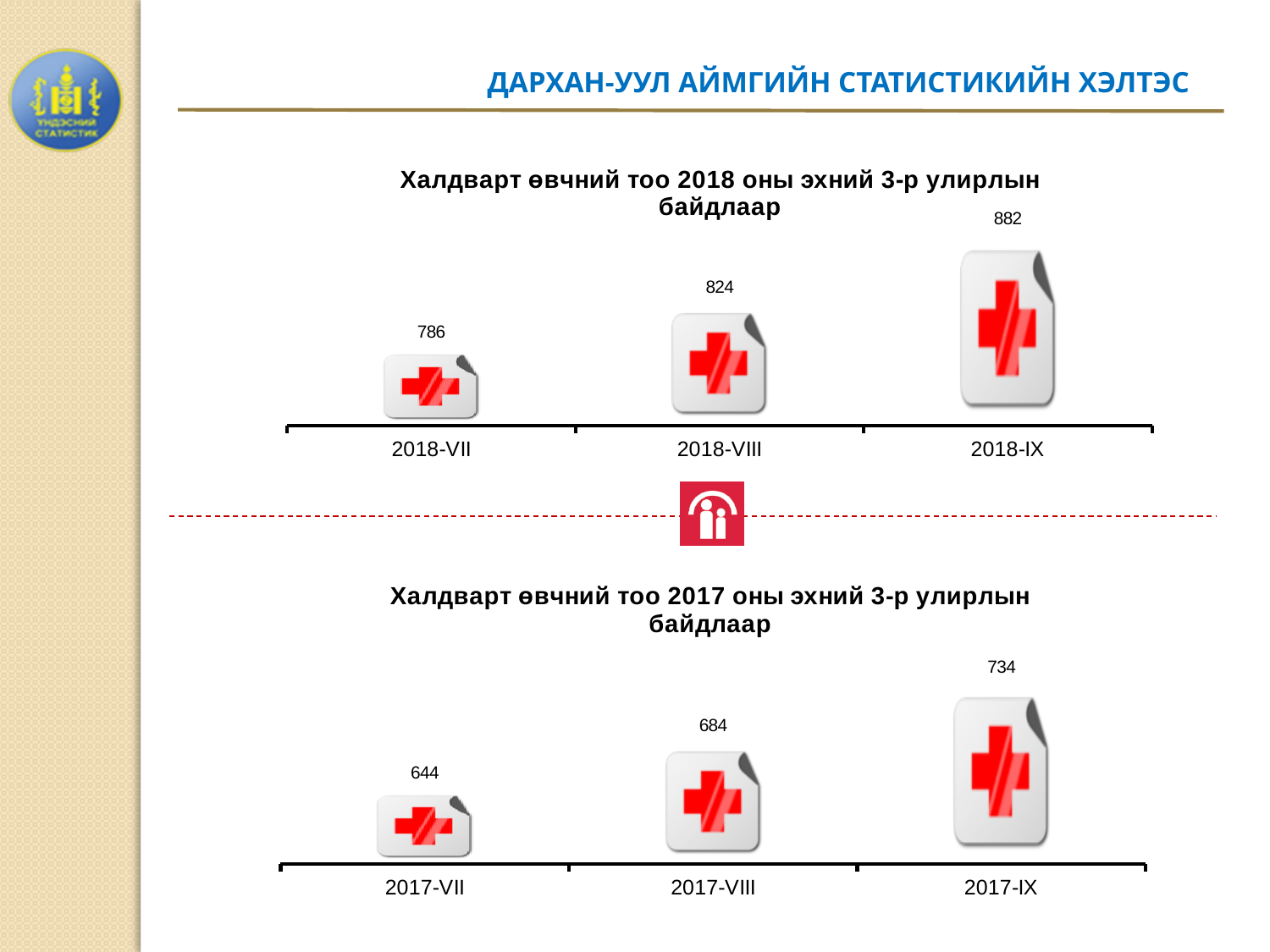
In the bottom chart (2017), what is the value for 2017-IX? 734 What kind of chart is the top chart (2018)? bar chart In the bottom chart (2017), what is the value for 2017-VIII? 684 In the top chart (2018), what is the difference between the values for 2018-IX and 2018-VII? 96 In the top chart (2018), what is the value for 2018-VII? 786 Which is larger: the value for 2018-VIII in the top chart or the value for 2017-IX in the bottom chart? 2018-VIII How many categories are shown in the bottom chart (2017)? 3 In the bottom chart (2017), which month has the lowest value? 2017-VII In the top chart (2018), which month has the highest value? 2018-IX Do the values in the top chart (2018) rise or fall from 2018-VII to 2018-IX? rise In the top chart (2018), what is the value for 2018-IX? 882 In the bottom chart (2017), what is the difference between the values for 2017-VIII and 2017-VII? 40